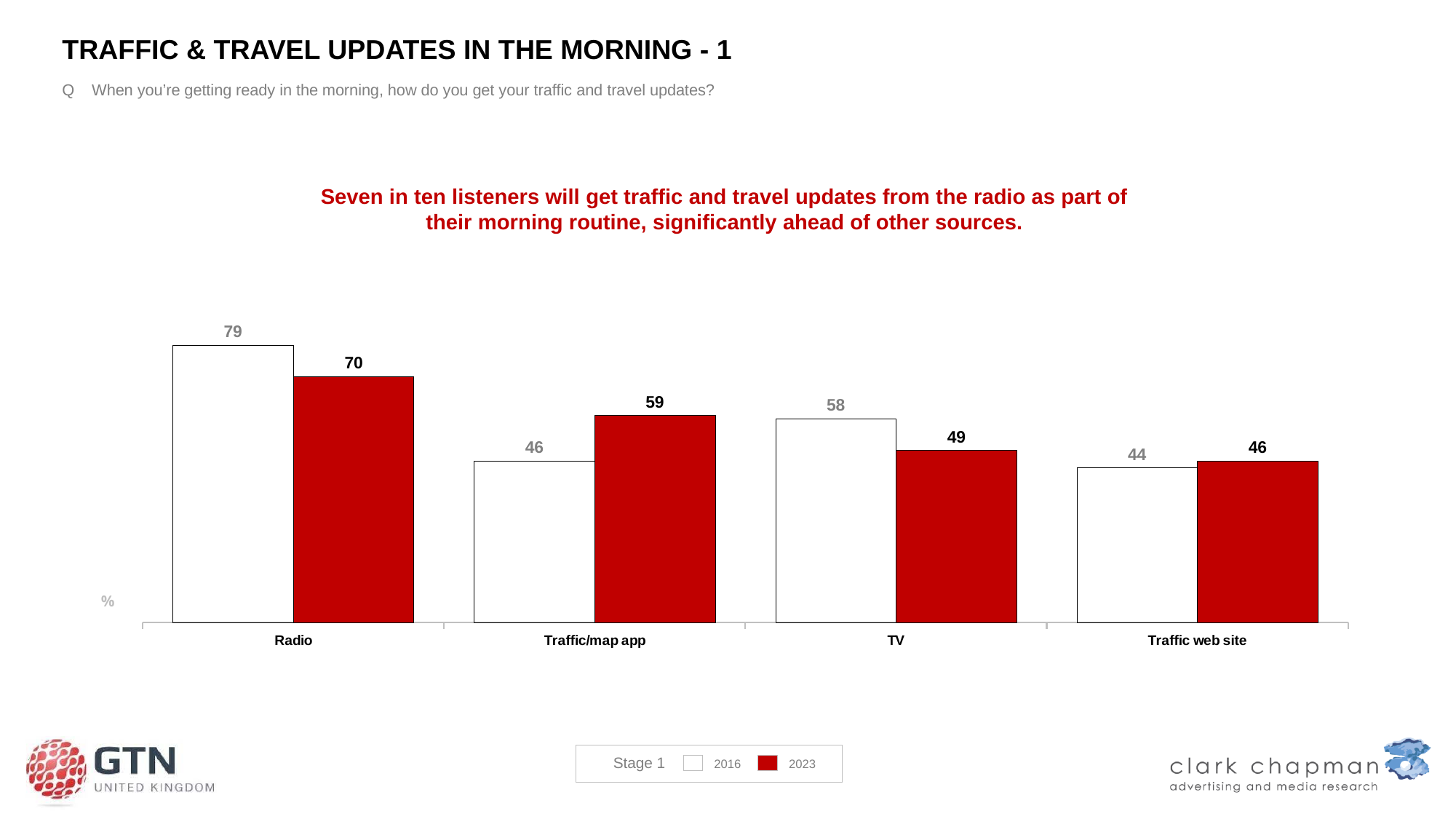
What is the 2023 value for Radio? 70 What is the 2016 value for Traffic/map app? 46 Which category has the highest 2016 value? Radio What is the difference between the 2023 and 2016 values for Traffic/map app? 13 Which is larger for TV: the 2016 value or the 2023 value? 2016 Which category has the lowest 2023 value? Traffic web site What kind of chart is shown on the slide? Bar chart What is the 2023 value for TV? 49 How many series does the legend list? 2 How many categories are shown on the x axis? 4 What is the difference between the 2016 and 2023 values for Radio? 9 Which colour represents the 2023 series in the legend? Red